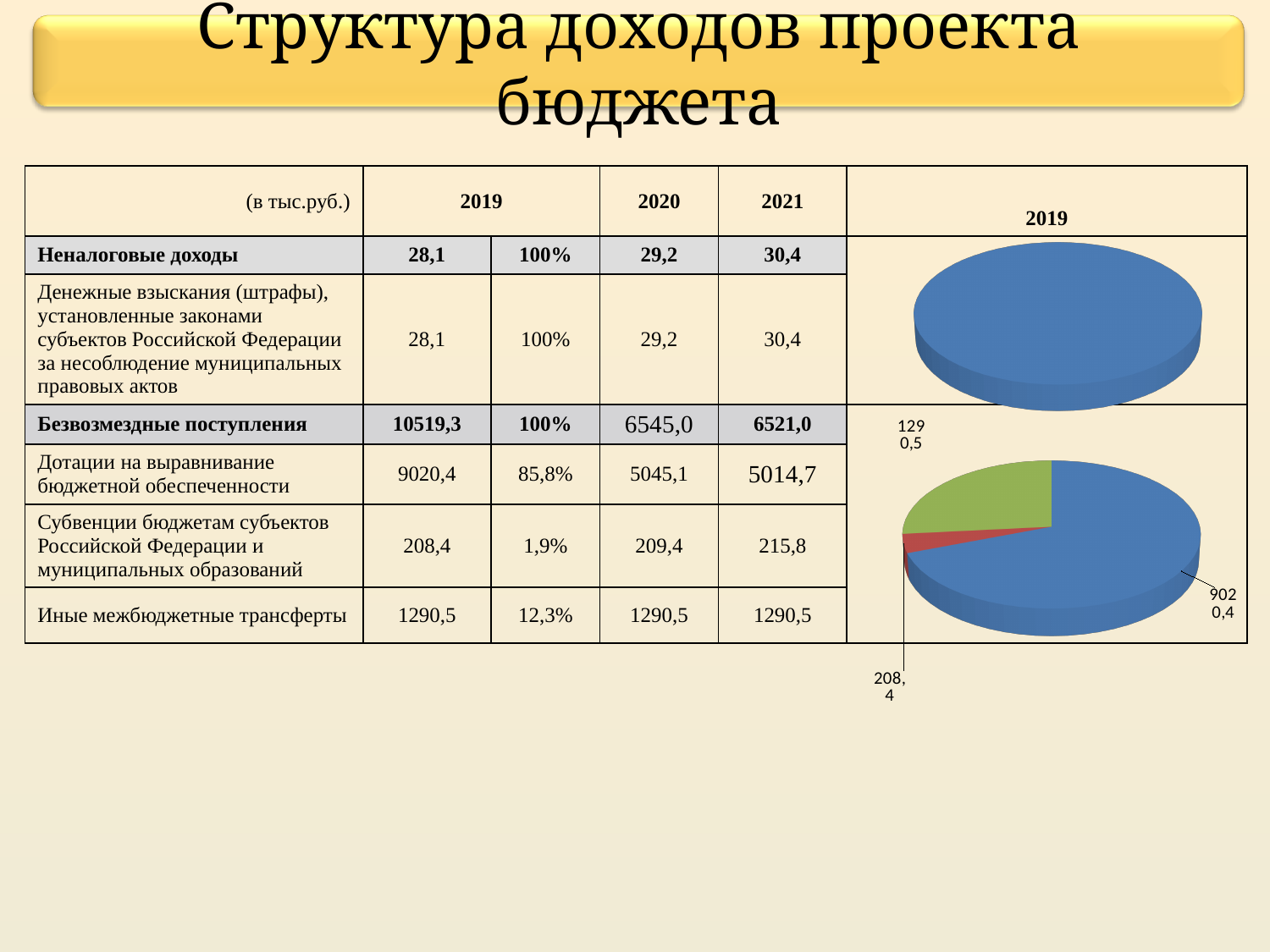
In the bottom pie chart, what value is labelled on the blue slice? 9020,4 How many slices does the bottom pie chart have? 3 In the bottom pie chart, which slice is larger, the green one or the red one? green What kind of chart is the top chart on the right of the slide? pie chart In the bottom pie chart, what value is labelled on the green slice? 1290,5 In the bottom pie chart, what value is labelled on the red slice? 208,4 What kind of chart is the bottom chart on the right of the slide? pie chart How many slices does the top pie chart have? 1 What colour is the single slice of the top pie chart? blue In the bottom pie chart, which colour slice is the smallest? red What is the title of the top pie chart? 2019 In the bottom pie chart, which colour slice is the largest? blue